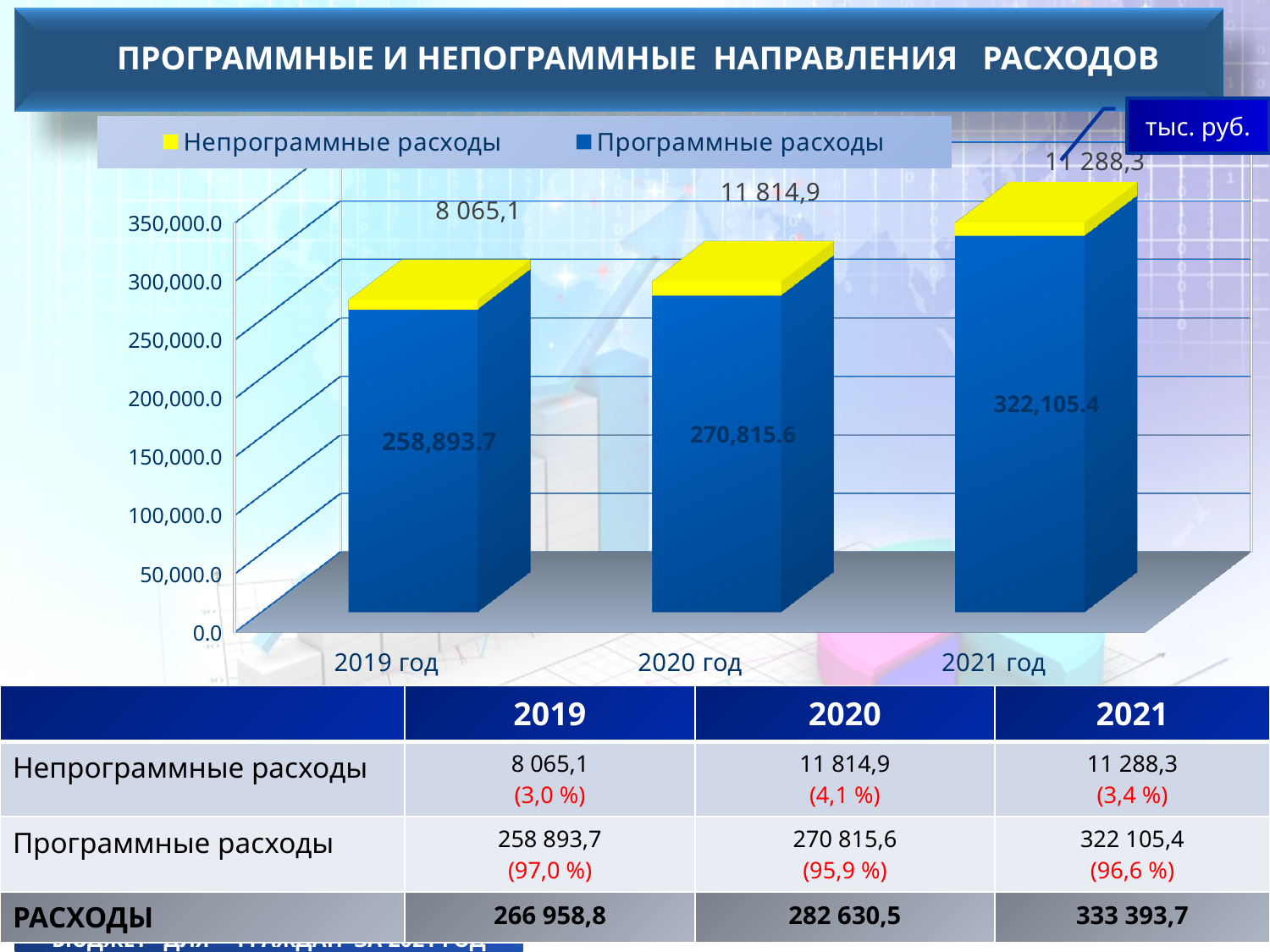
Which year has the lowest value of Непрограммные расходы? 2019 год Is the value of Программные расходы for 2020 год greater or less than 250,000.0? greater What is the value of Непрограммные расходы for 2019 год? 8 065,1 Which colour represents Непрограммные расходы in the chart? yellow What type of chart is shown on the slide? bar chart Do the values of Программные расходы rise or fall from 2019 год to 2021 год? rise What is the value of Непрограммные расходы for 2020 год? 11 814,9 Which year has the highest value of Программные расходы? 2021 год How many years are shown on the x axis of the chart? 3 What is the value of Программные расходы for 2021 год? 322,105.4 How many series does the chart legend list? 2 What is the value of Программные расходы for 2019 год? 258,893.7